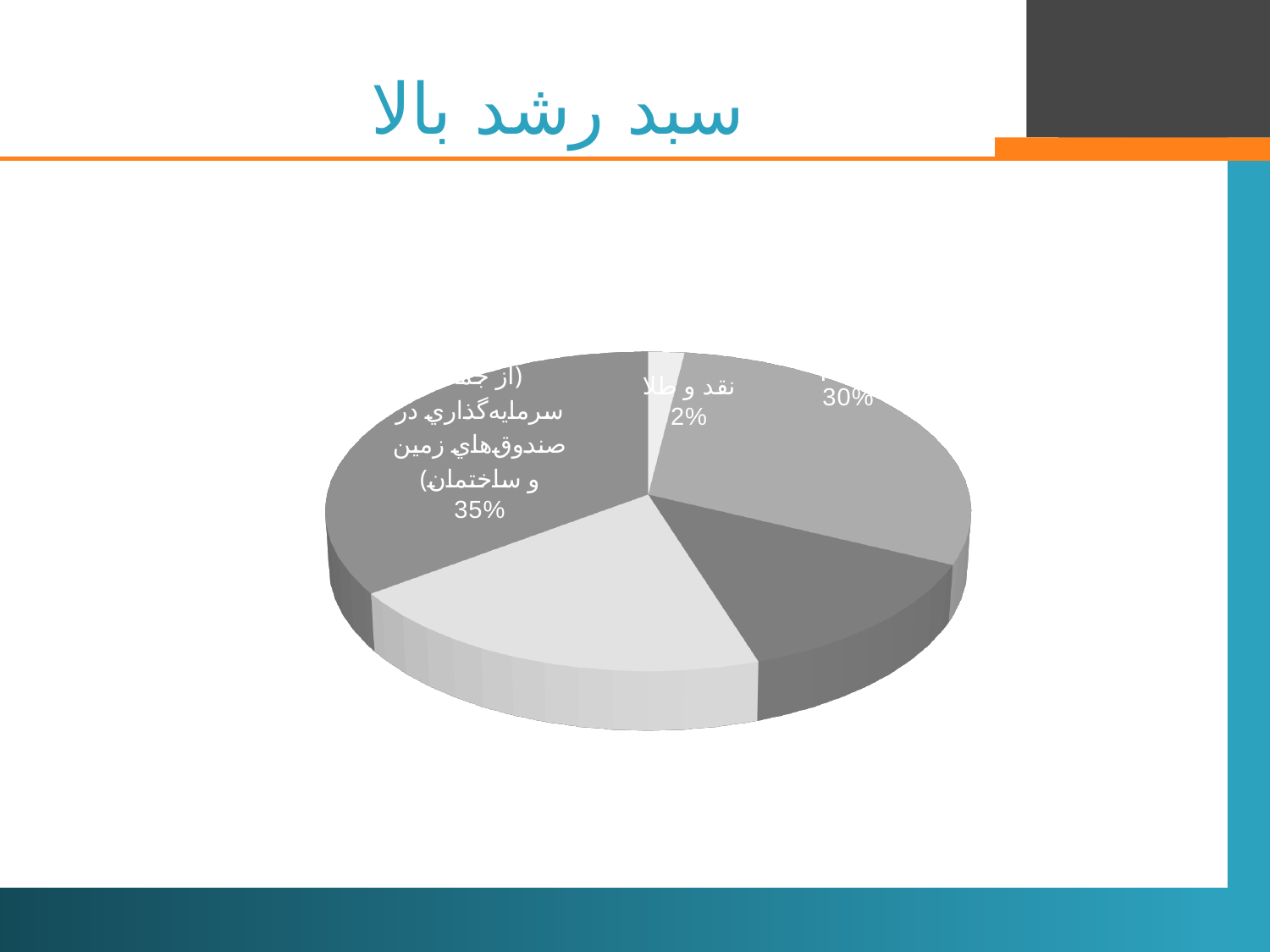
Which labelled slice has the smallest share of the pie? نقد و طلا What is the difference between the 35% slice and the نقد و طلا slice? 33% Is the slice labelled 35% larger or smaller than the slice labelled 30%? larger Which is larger: the slice labelled 30% or the slice labelled نقد و طلا? the slice labelled 30% What is the title of the slide containing the pie chart? سبد رشد بالا Is the pie chart drawn in 3D or flat 2D? 3D What share of the pie is labelled for نقد و طلا? 2% What kind of chart is shown on the slide? pie chart How many slices does the pie chart have? 5 What share is labelled on the slice whose label mentions صندوق‌های زمین و ساختمان? 35%